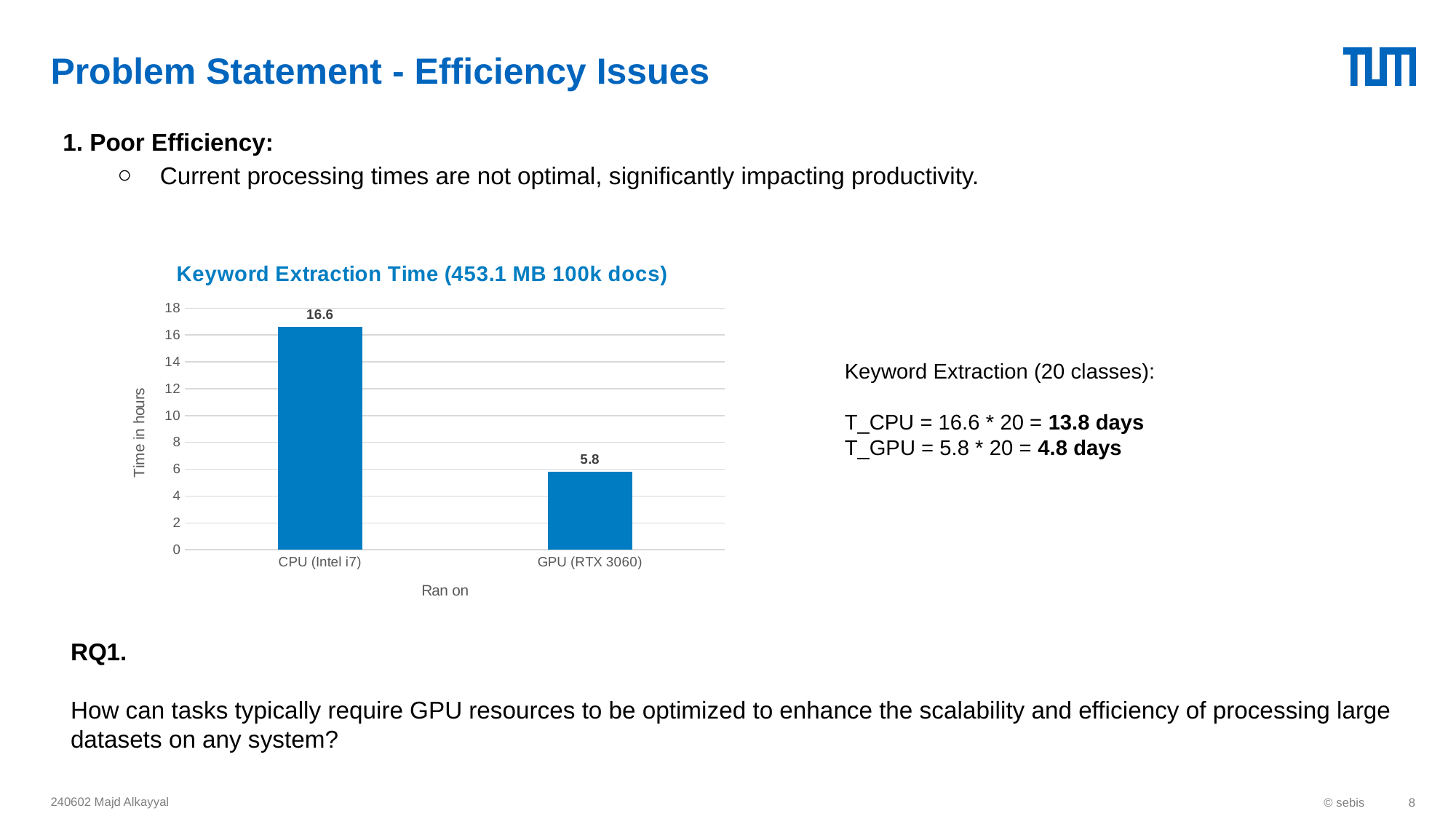
Which category has the lowest time in hours? GPU (RTX 3060) Which is larger, the value for CPU (Intel i7) or GPU (RTX 3060)? CPU (Intel i7) Which category has the highest time in hours? CPU (Intel i7) What is the keyword extraction time for GPU (RTX 3060)? 5.8 What kind of chart is shown on the slide? bar chart How many categories are shown on the x axis? 2 What is the label of the y axis? Time in hours What is the keyword extraction time for CPU (Intel i7)? 16.6 What is the title of the chart? Keyword Extraction Time (453.1 MB 100k docs) What is the difference in hours between the CPU (Intel i7) and GPU (RTX 3060) bars? 10.8 Is the value for CPU (Intel i7) greater or less than 14? greater Is the value for GPU (RTX 3060) greater or less than 8? less